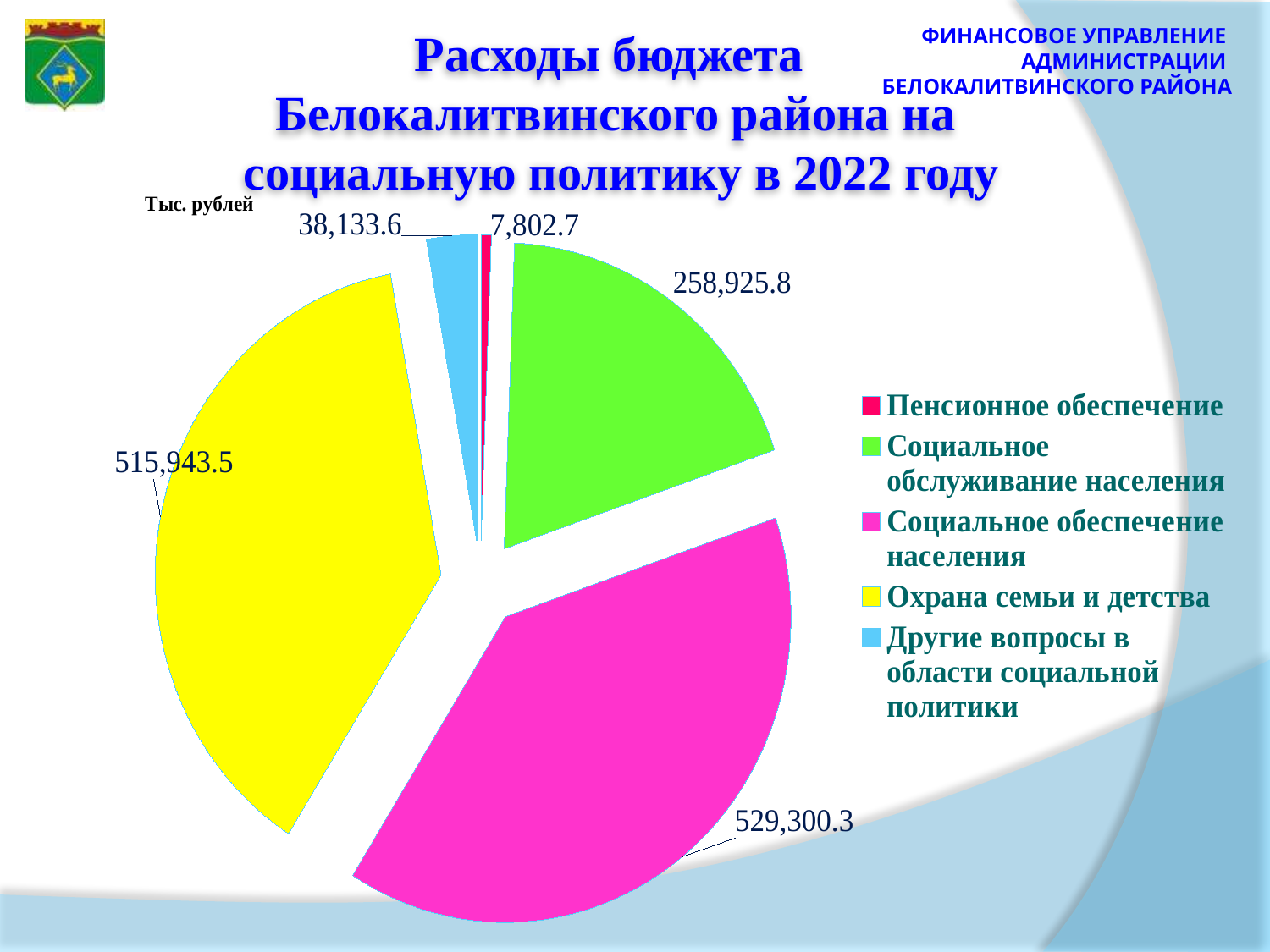
What is the difference between Социальное обеспечение населения and Охрана семьи и детства? 13,356.8 What is the value for Охрана семьи и детства? 515,943.5 What unit is indicated for the values in the chart? Тыс. рублей What is the value for Другие вопросы в области социальной политики? 38,133.6 What is the value for Пенсионное обеспечение? 7,802.7 Which is larger: Социальное обслуживание населения or Другие вопросы в области социальной политики? Социальное обслуживание населения What is the value for Социальное обеспечение населения? 529,300.3 Which category has the smallest value? Пенсионное обеспечение What type of chart is shown on the slide? pie chart Which category has the largest value? Социальное обеспечение населения What is the value for Социальное обслуживание населения? 258,925.8 How many slices does the pie chart have? 5